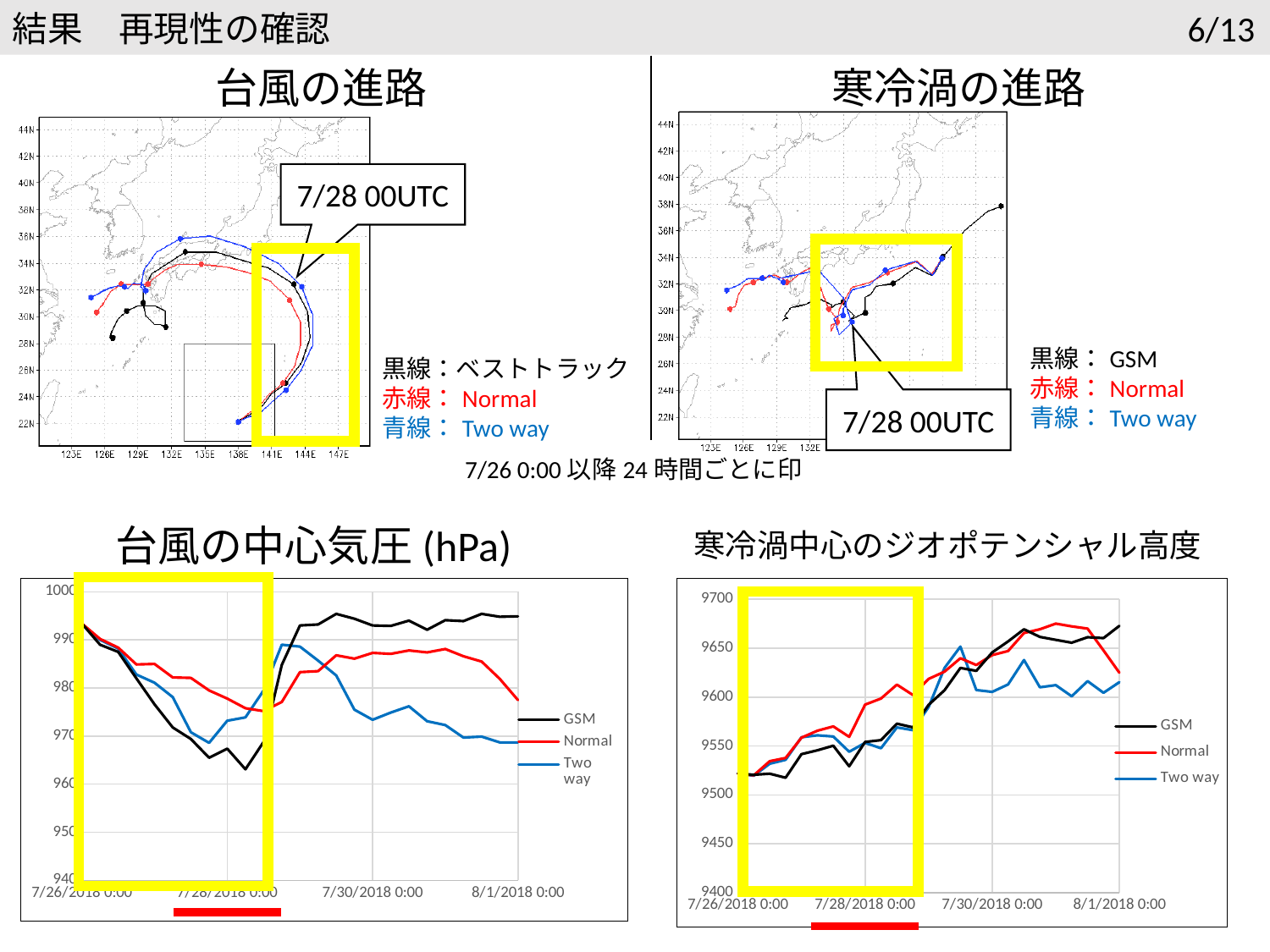
In the '寒冷渦中心のジオポテンシャル高度' chart, is the GSM value at 8/1/2018 0:00 greater or less than 9650? greater In the '台風の中心気圧 (hPa)' chart, is the GSM value at 8/1/2018 0:00 greater or less than 990? greater How many series does the legend of the '台風の中心気圧 (hPa)' chart list? 3 In the '台風の中心気圧 (hPa)' chart, is the lowest value of the GSM series greater or less than 970? less In the '寒冷渦中心のジオポテンシャル高度' chart, what colour is the Normal series line? red In the '台風の中心気圧 (hPa)' chart, does the GSM series rise or fall between 7/26/2018 0:00 and 7/28/2018 0:00? fall In the '寒冷渦中心のジオポテンシャル高度' chart, do the values generally rise or fall from 7/26/2018 0:00 to 8/1/2018 0:00? rise In the '台風の中心気圧 (hPa)' chart, which series is higher at 8/1/2018 0:00, GSM or Two way? GSM What kind of chart is the '台風の中心気圧 (hPa)' chart? line chart How many series does the legend of the '寒冷渦中心のジオポテンシャル高度' chart list? 3